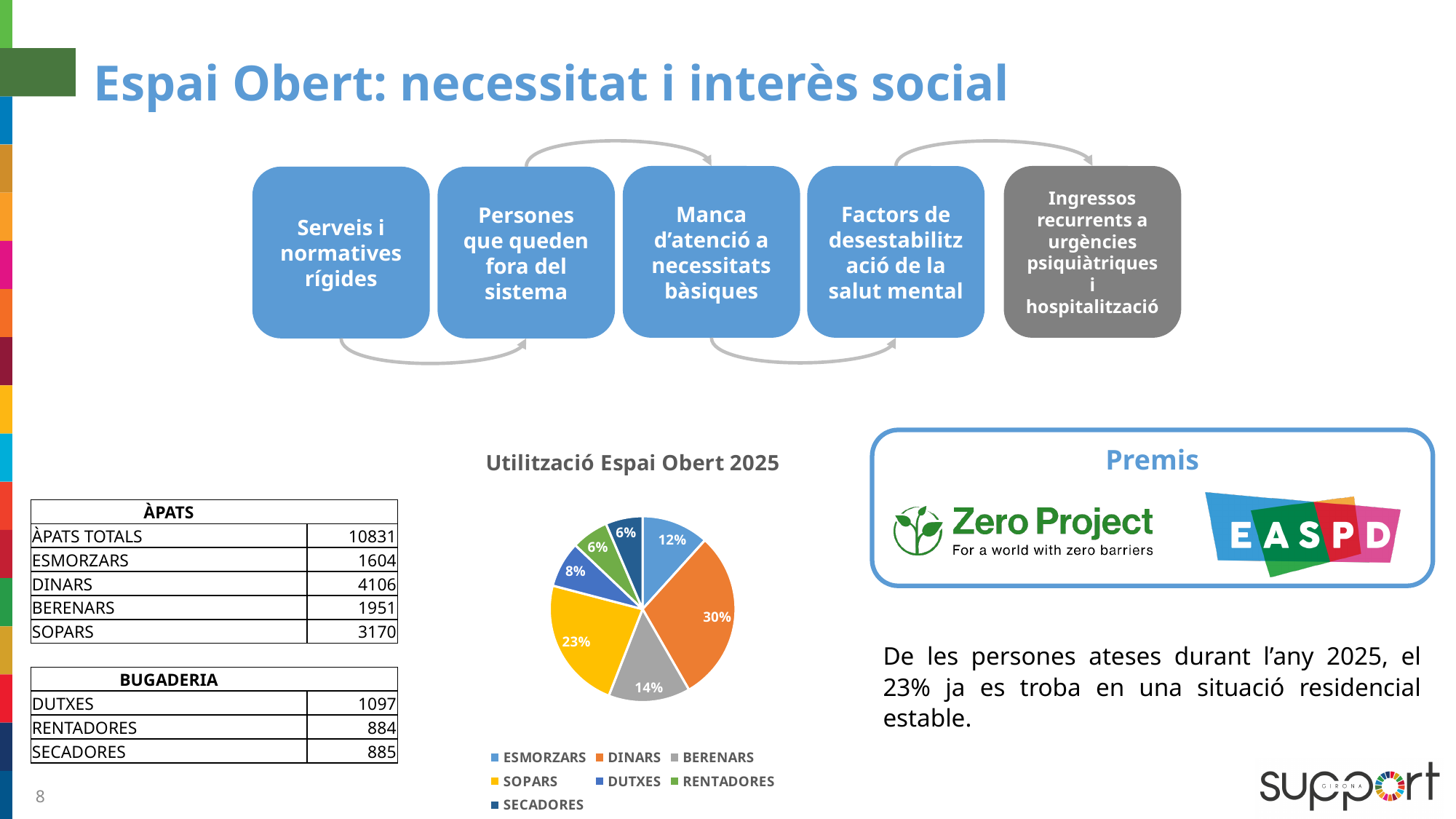
In the pie chart "Utilització Espai Obert 2025", what is the difference between the DINARS share and the ESMORZARS share? 18% In the pie chart "Utilització Espai Obert 2025", what share does DINARS have? 30% How many categories does the legend of the pie chart "Utilització Espai Obert 2025" list? 7 In the pie chart "Utilització Espai Obert 2025", what share does SOPARS have? 23% In the pie chart "Utilització Espai Obert 2025", what share does DUTXES have? 8% In the pie chart "Utilització Espai Obert 2025", which is larger, SOPARS or BERENARS? SOPARS In the pie chart "Utilització Espai Obert 2025", what share does BERENARS have? 14% Which category has the largest slice in the pie chart "Utilització Espai Obert 2025"? DINARS In the pie chart "Utilització Espai Obert 2025", what is the combined share of DUTXES, RENTADORES and SECADORES? 20% In the pie chart "Utilització Espai Obert 2025", what share does ESMORZARS have? 12% What is the title of the pie chart on the slide? Utilització Espai Obert 2025 What kind of chart is "Utilització Espai Obert 2025"? pie chart